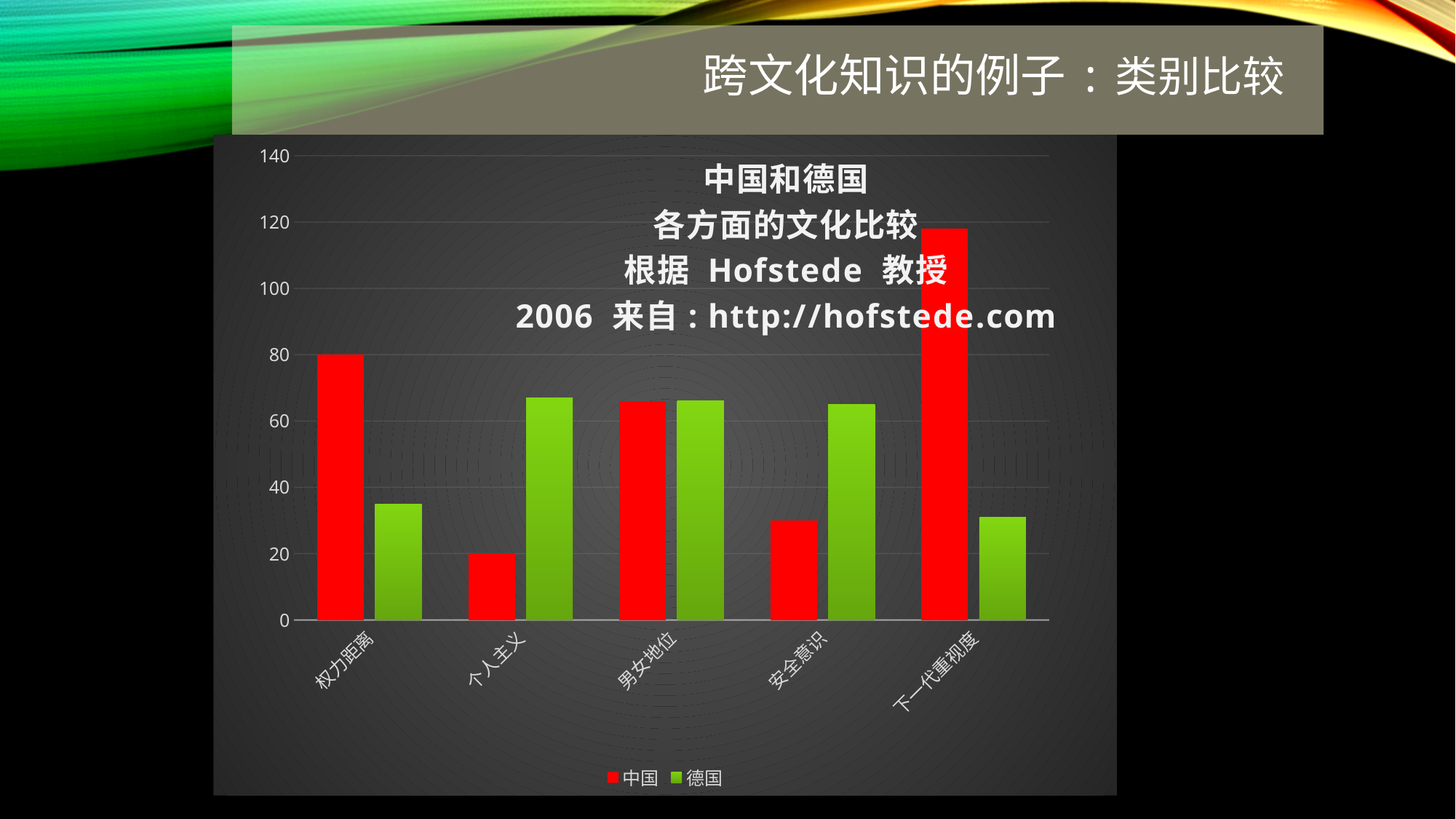
In the 权力距离 category, which series has the larger value, 中国 or 德国? 中国 Is the value for 德国 in the 安全意识 category greater or less than 60? greater In the 个人主义 category, which series has the larger value, 中国 or 德国? 德国 How many categories are shown on the x axis of the chart? 5 Which colour represents 德国 in the chart? green What kind of chart is shown on the slide? bar chart In which category does 中国 have its highest value? 下一代重视度 In which category does 中国 have its lowest value? 个人主义 What is the value for 中国 in the 个人主义 category? 20 How many series does the chart legend list? 2 What is the value for 中国 in the 权力距离 category? 80 Is the value for 中国 in the 下一代重视度 category greater or less than 100? greater